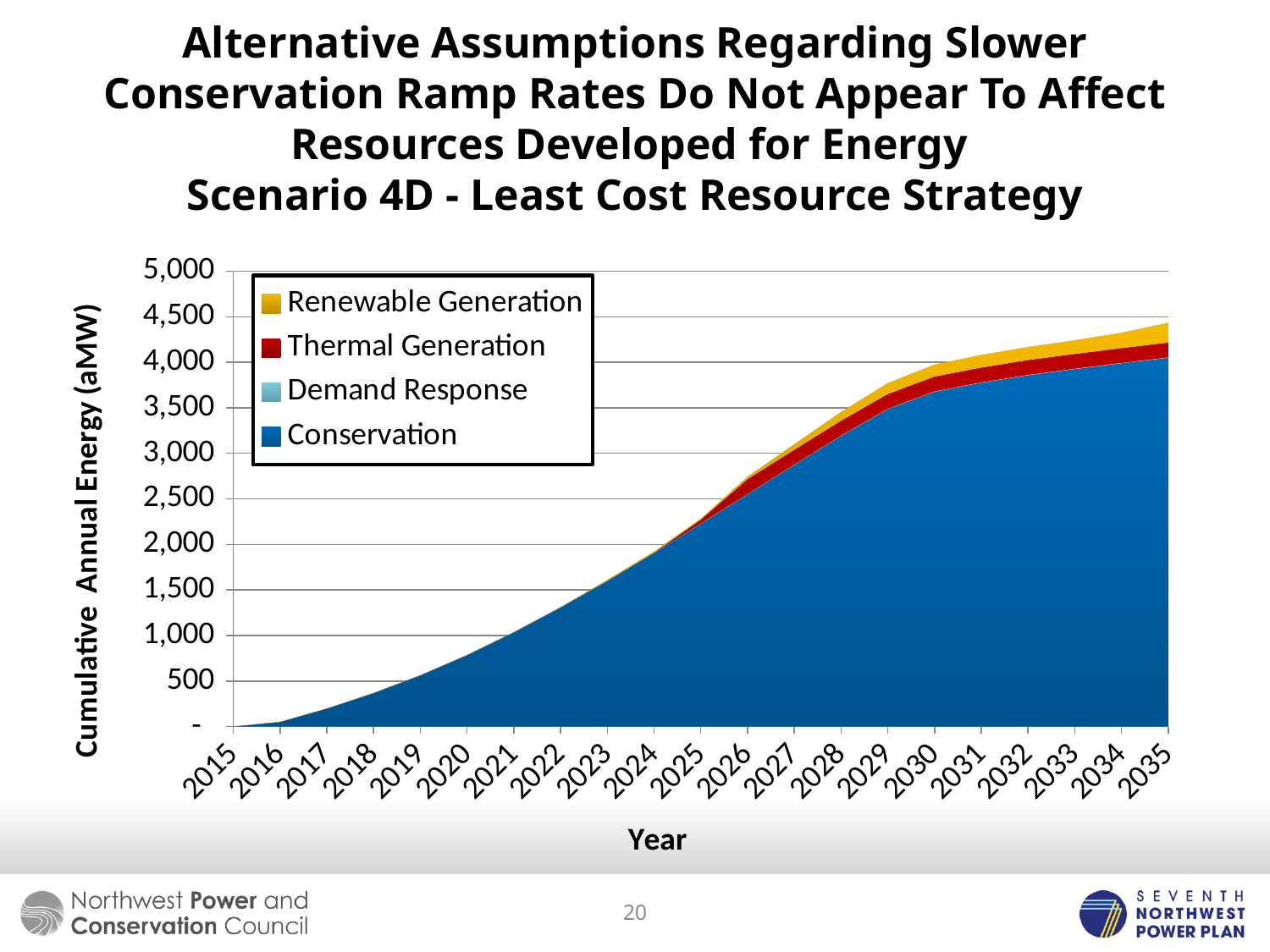
Is the Conservation value in 2018 greater or less than 500 aMW? less Which series contributes the largest share of cumulative annual energy in 2035? Conservation Does the total cumulative annual energy rise or fall from 2015 to 2035? Rises Which series contributes the smallest share of cumulative annual energy in 2035? Demand Response Is the Conservation value in 2020 greater or less than 1,000 aMW? less Is the total cumulative annual energy in 2035 greater or less than 4,000 aMW? greater In 2035, which is larger: the Conservation contribution or the Thermal Generation contribution? Conservation How many years are shown along the x axis? 21 How many series does the legend list? 4 What kind of chart is shown on the slide? Stacked area chart What is the label on the y axis of the chart? Cumulative Annual Energy (aMW)